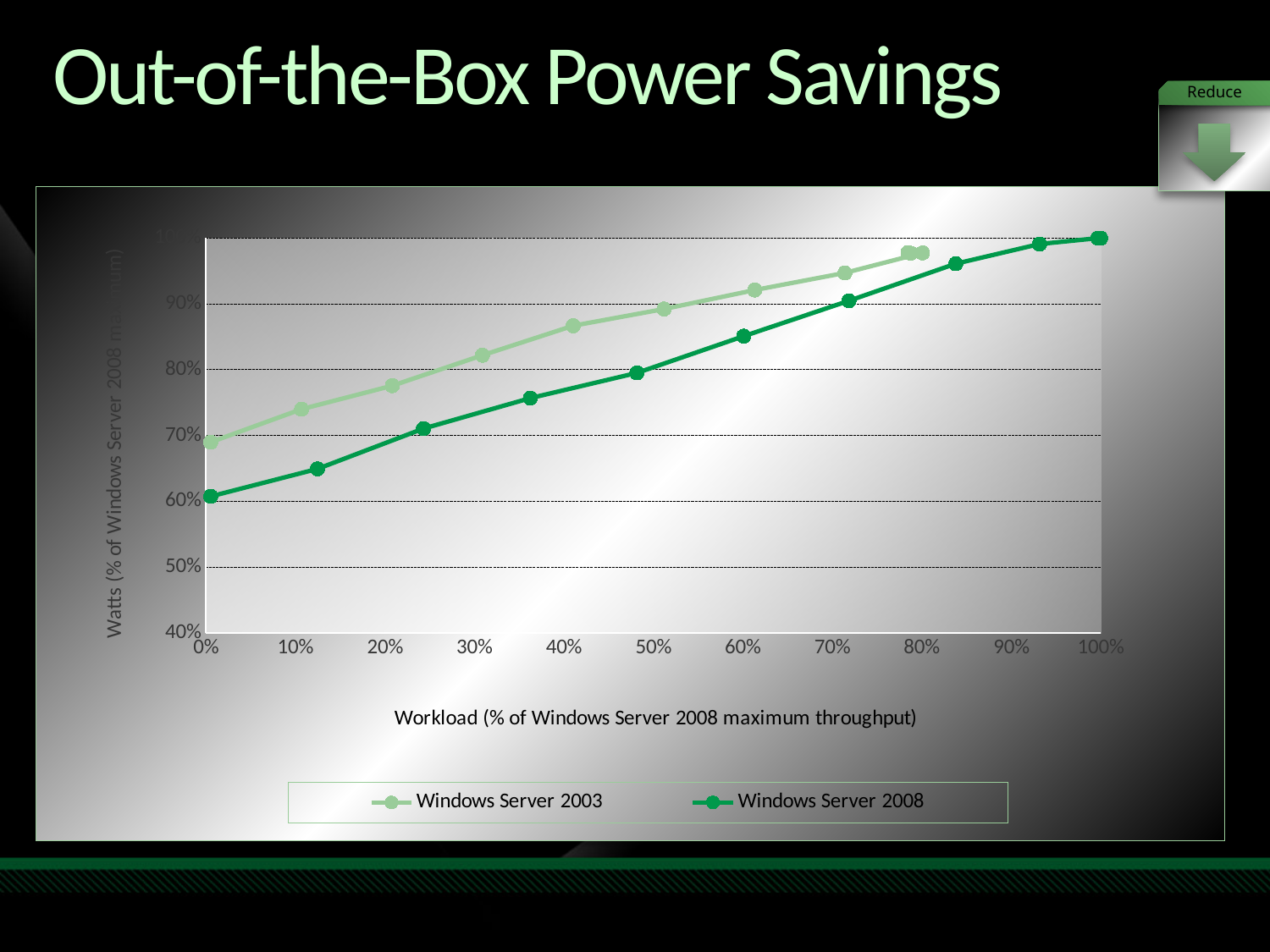
Is the value for Windows Server 2003 at 0% workload greater or less than 60%? greater Which two series are listed in the legend? Windows Server 2003 and Windows Server 2008 Do the values for Windows Server 2003 rise or fall as workload increases along the x axis? rise Which series has the lower value at 40% workload, Windows Server 2003 or Windows Server 2008? Windows Server 2008 How many series does the legend list? 2 What kind of chart is shown on the slide? line chart What is the x-axis title of the chart? Workload (% of Windows Server 2008 maximum throughput) Is the value for Windows Server 2003 at 40% workload greater or less than 80%? greater Do the values for Windows Server 2008 rise or fall as workload increases along the x axis? rise At 0% workload, which series has the higher value, Windows Server 2003 or Windows Server 2008? Windows Server 2003 Is the value for Windows Server 2008 at 100% workload greater or less than 90%? greater